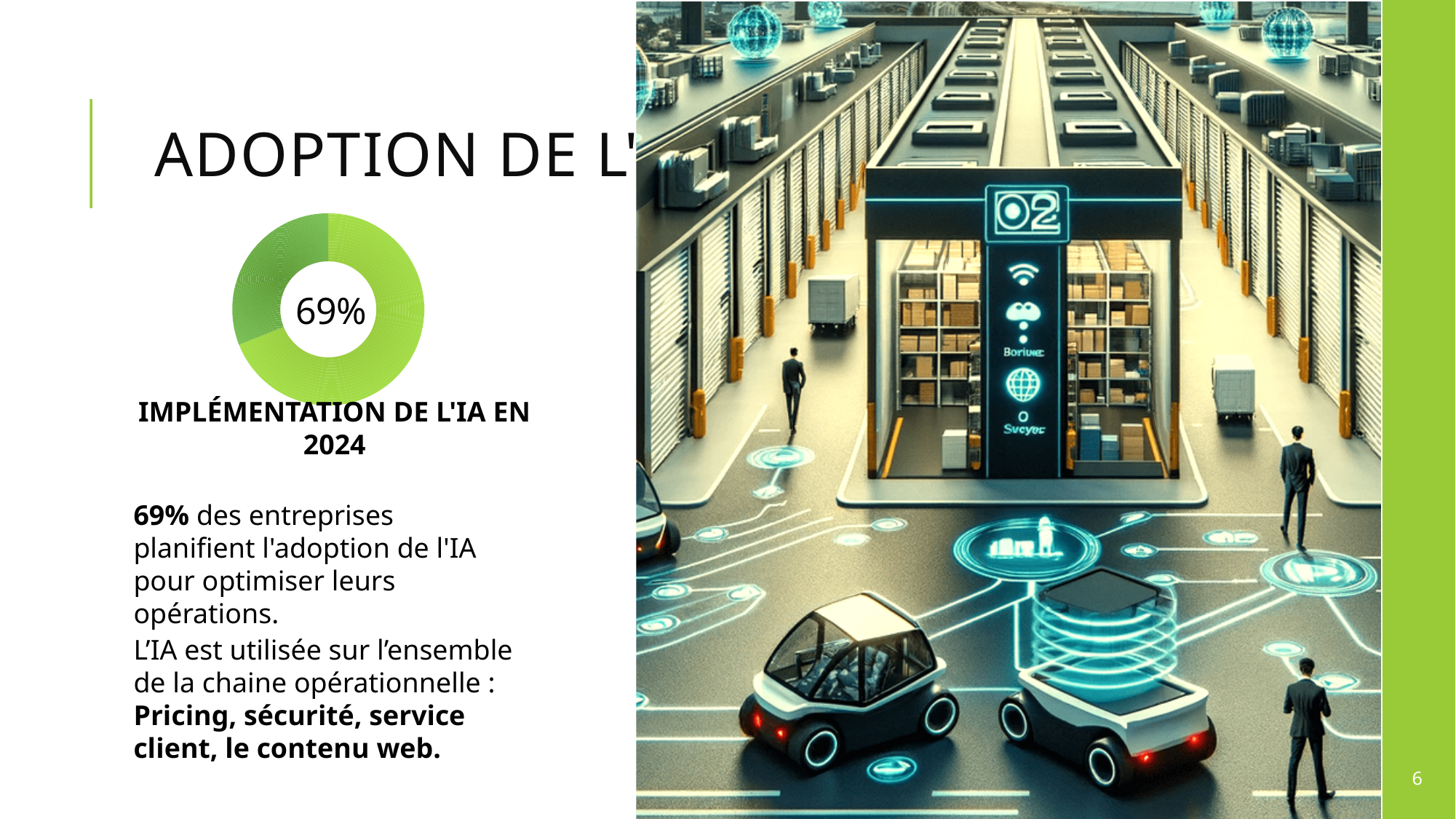
What is the caption printed under the donut chart? IMPLÉMENTATION DE L'IA EN 2024 How many slices does the donut chart have? 2 Is the remaining (non-highlighted) slice of the donut chart greater or less than 50%? less Is the highlighted slice of the donut chart greater or less than 50%? greater What value is printed in the centre of the donut chart? 69% What colour is used for the slices of the donut chart? green Which slice of the donut chart is larger, the highlighted 69% slice or the remaining slice? the 69% slice What kind of chart is shown on the slide? donut chart What share of the donut does the highlighted (bright green) slice represent? 69%